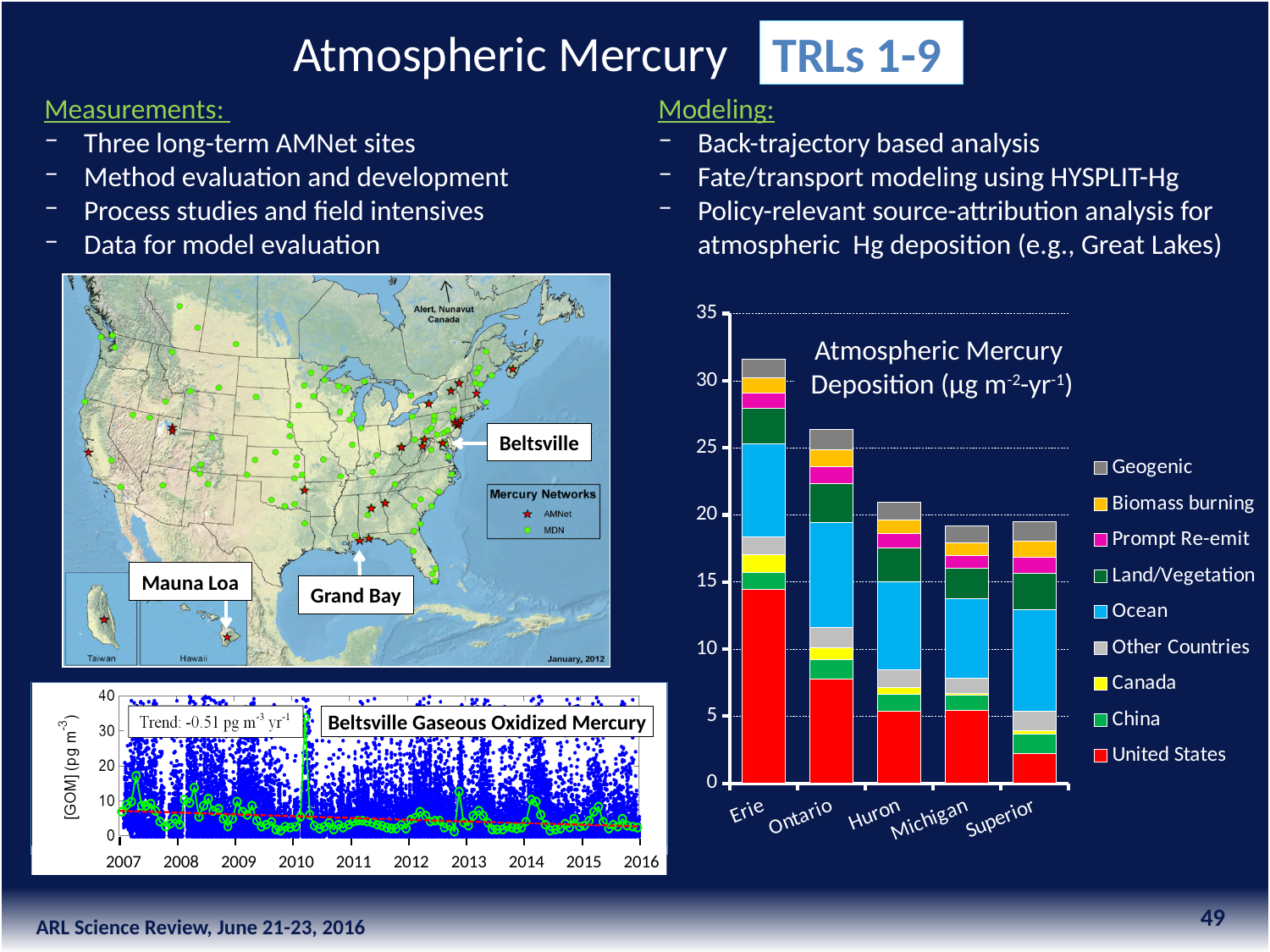
In the Atmospheric Mercury Deposition chart, how many lakes are shown on the x axis? 5 In the Atmospheric Mercury Deposition chart, is the total deposition for Superior greater or less than 20? less In the Atmospheric Mercury Deposition chart, is the total deposition for Erie greater or less than 30? greater In the Atmospheric Mercury Deposition chart, do the total bar heights generally rise or fall from Erie to Superior? fall In the Atmospheric Mercury Deposition chart, is the United States contribution for Superior greater or less than 5? less In the Beltsville Gaseous Oxidized Mercury chart, what trend value is printed on the plot? -0.51 pg m-3 yr-1 In the Atmospheric Mercury Deposition chart, which legend entry is shown in red? United States In the Atmospheric Mercury Deposition chart, which lake has the highest total deposition? Erie In the Atmospheric Mercury Deposition chart, how many source categories does the legend list? 9 In the Atmospheric Mercury Deposition chart, what kind of chart is used? stacked bar chart In the Atmospheric Mercury Deposition chart, which has the larger United States contribution, Erie or Superior? Erie